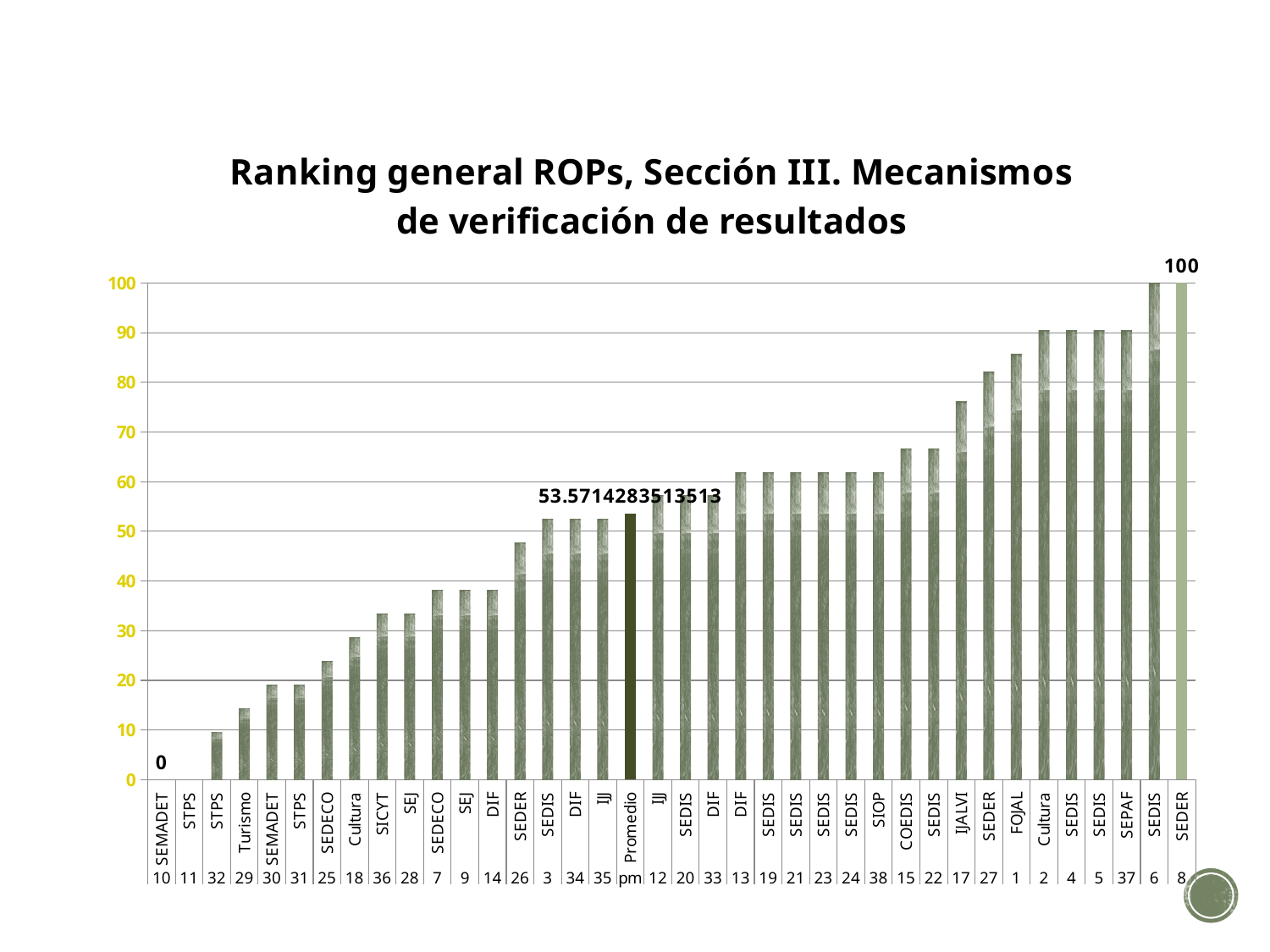
Is the value for FOJAL 1 greater or less than 80? greater Do the values generally rise or fall from left to right along the x axis? rise What value is shown for Promedio (pm)? 53.5714283513513 Is the value for IJALVI 17 greater or less than 70? greater How many categories are shown on the x axis? 38 What is the title of the chart? Ranking general ROPs, Sección III. Mecanismos de verificación de resultados Is the value for Turismo 29 greater or less than 20? less What value is shown for SEMADET 10, the first bar on the left? 0 What type of chart is shown on the slide? bar chart Which has a larger value, Turismo 29 or SEDER 27? SEDER 27 What value is shown for SEDER 8, the last bar on the right? 100